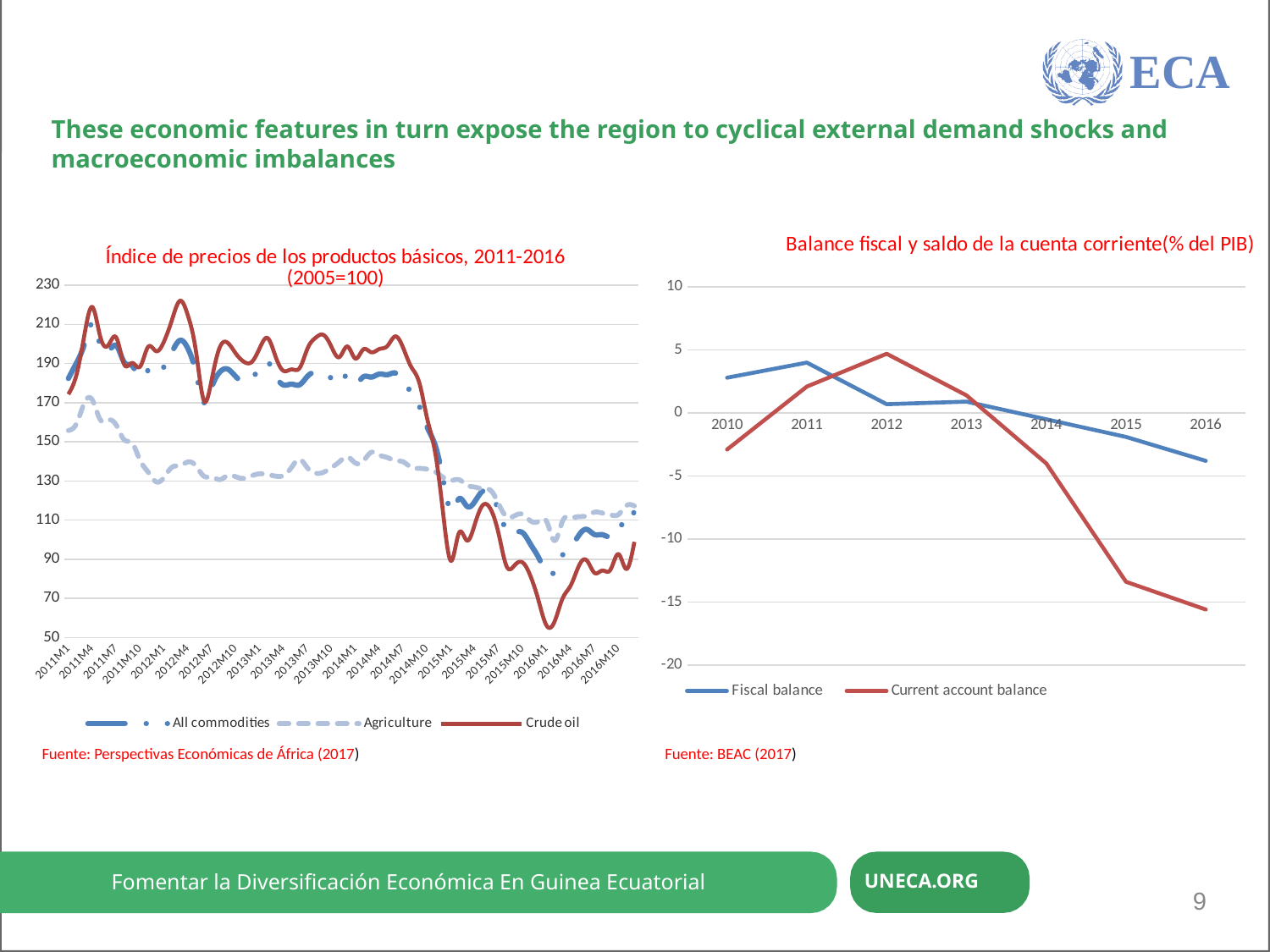
What kind of chart is the right chart, 'Balance fiscal y saldo de la cuenta corriente(% del PIB)'? line chart How many years are shown on the x axis of the right chart? 7 In the right chart, which series has the higher value in 2016, Fiscal balance or Current account balance? Fiscal balance In the right chart, does the Current account balance rise or fall from 2012 to 2016? fall In the right chart, is the Current account balance for 2015 greater or less than -10? less In the right chart, is the Current account balance for 2010 greater or less than 0? less In the left chart, is the Crude oil value at 2016M1 greater or less than 70? less How many series does the legend of the left chart list? 3 What kind of chart is the left chart, 'Índice de precios de los productos básicos, 2011-2016'? line chart In the left chart, which series is named in the legend with a solid red line? Crude oil How many series does the legend of the right chart list? 2